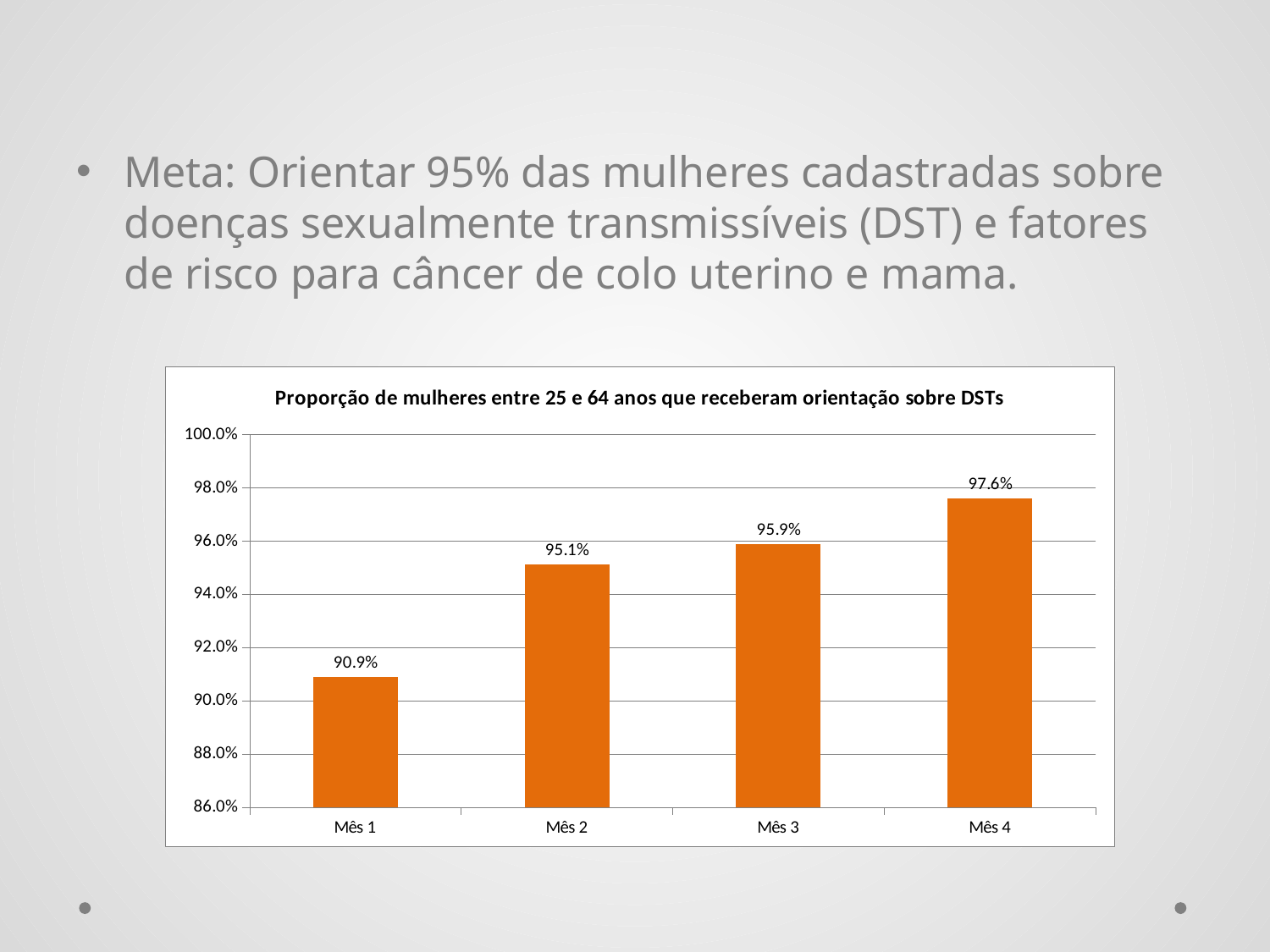
How many months are shown on the x axis? 4 What kind of chart is shown on the slide? bar chart Do the values rise or fall from Mês 1 to Mês 4? rise Which month has the lowest value? Mês 1 Is the value for Mês 2 greater or less than 94.0%? greater What is the value for Mês 1? 90.9% Which month has the highest value? Mês 4 What is the value for Mês 4? 97.6% Which is larger, the value for Mês 2 or the value for Mês 3? Mês 3 What is the value for Mês 3? 95.9% What is the difference between the values for Mês 4 and Mês 1? 6.7% What is the difference between the values for Mês 2 and Mês 1? 4.2%